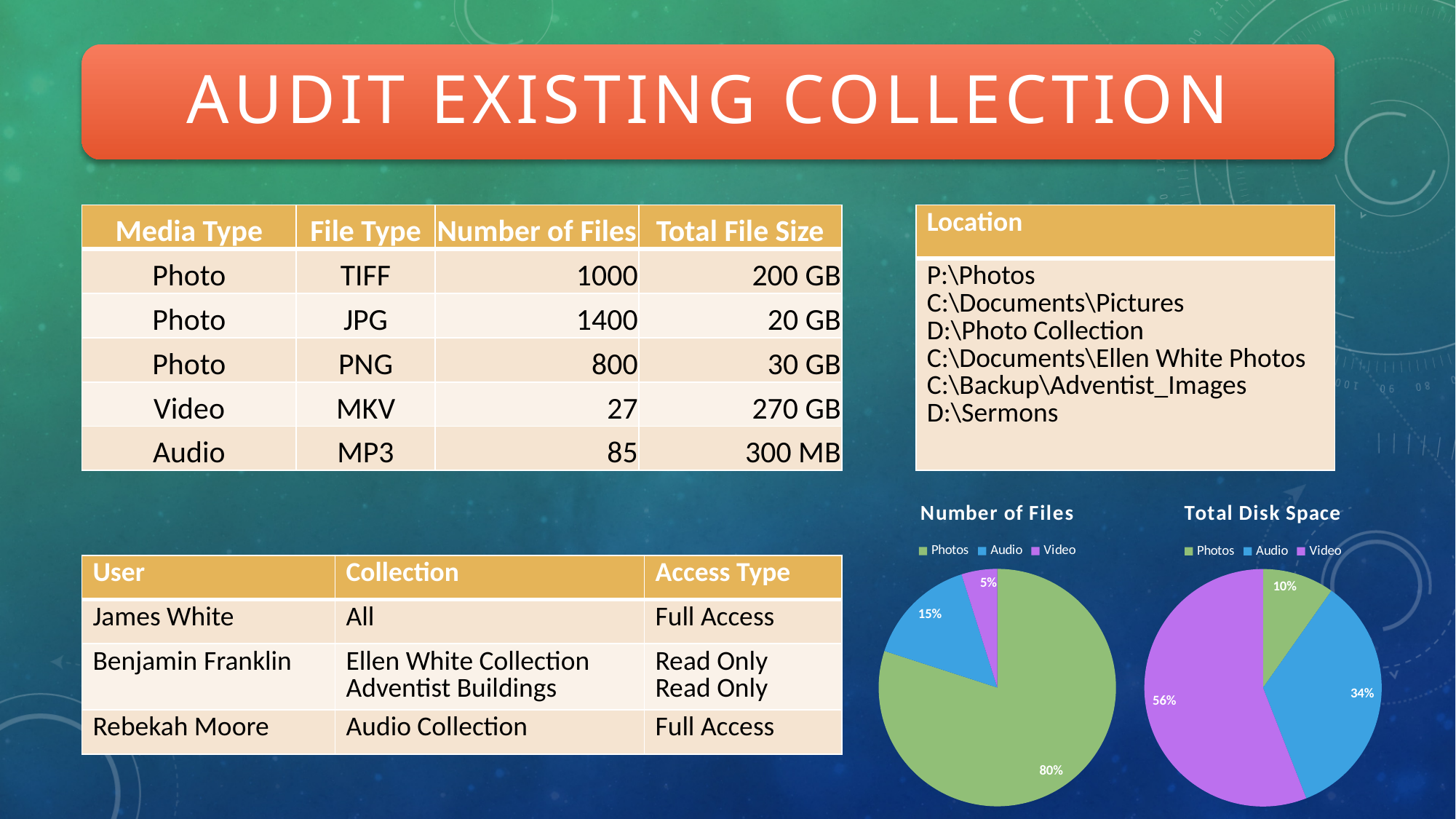
In the Total Disk Space chart, what share of the pie is the blue slice (Audio)? 34% What kind of chart is the Total Disk Space chart? Pie chart In the Number of Files chart, what is the difference in percentage points between the Photos slice and the Audio slice? 65 In the Number of Files chart, what share of the pie is Photos? 80% In the Number of Files chart, what share of the pie is Video? 5% How many categories does the legend of the Number of Files chart list? 3 In the Total Disk Space chart, which category has the smallest slice? Photos In the Number of Files chart, which category has the smallest slice? Video In the Number of Files chart, which category has the largest slice? Photos